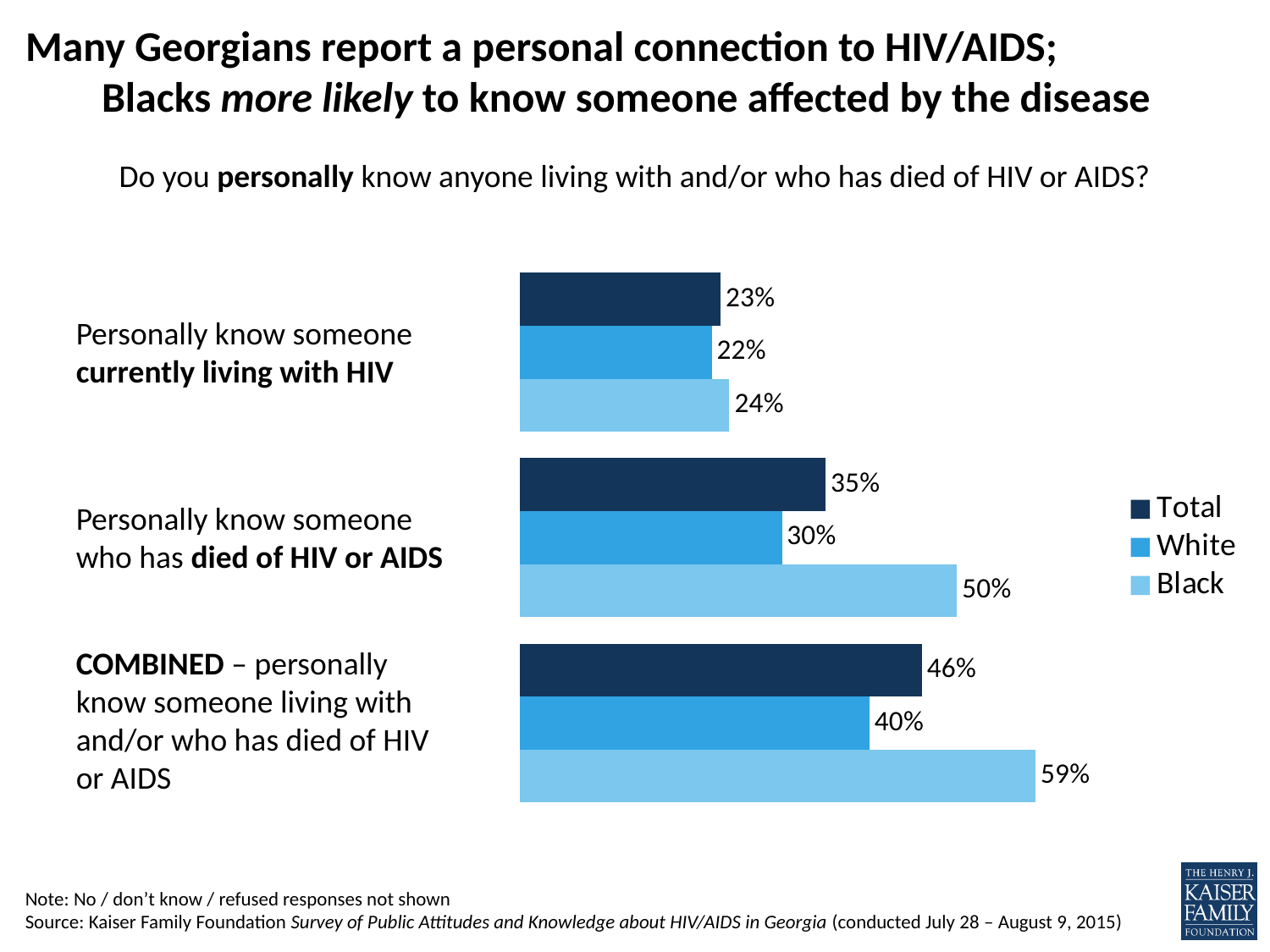
Is the Total value higher for knowing someone who has died of HIV or AIDS or for knowing someone currently living with HIV? Died of HIV or AIDS What is the difference between the Black and White values for personally knowing someone who has died of HIV or AIDS? 20 percentage points How many categories are shown on the chart? 3 What is the White value for the COMBINED category? 40% Which series has the lowest value for personally knowing someone currently living with HIV? White What type of chart is shown on the slide? Bar chart Which series has the highest value in the COMBINED category? Black What is the difference between the Black and Total values in the COMBINED category? 13 percentage points What percentage of Black respondents personally know someone who has died of HIV or AIDS? 50% What is the Total value for personally knowing someone currently living with HIV? 23% Which series is shown in the darkest blue colour? Total How many series does the legend list? 3